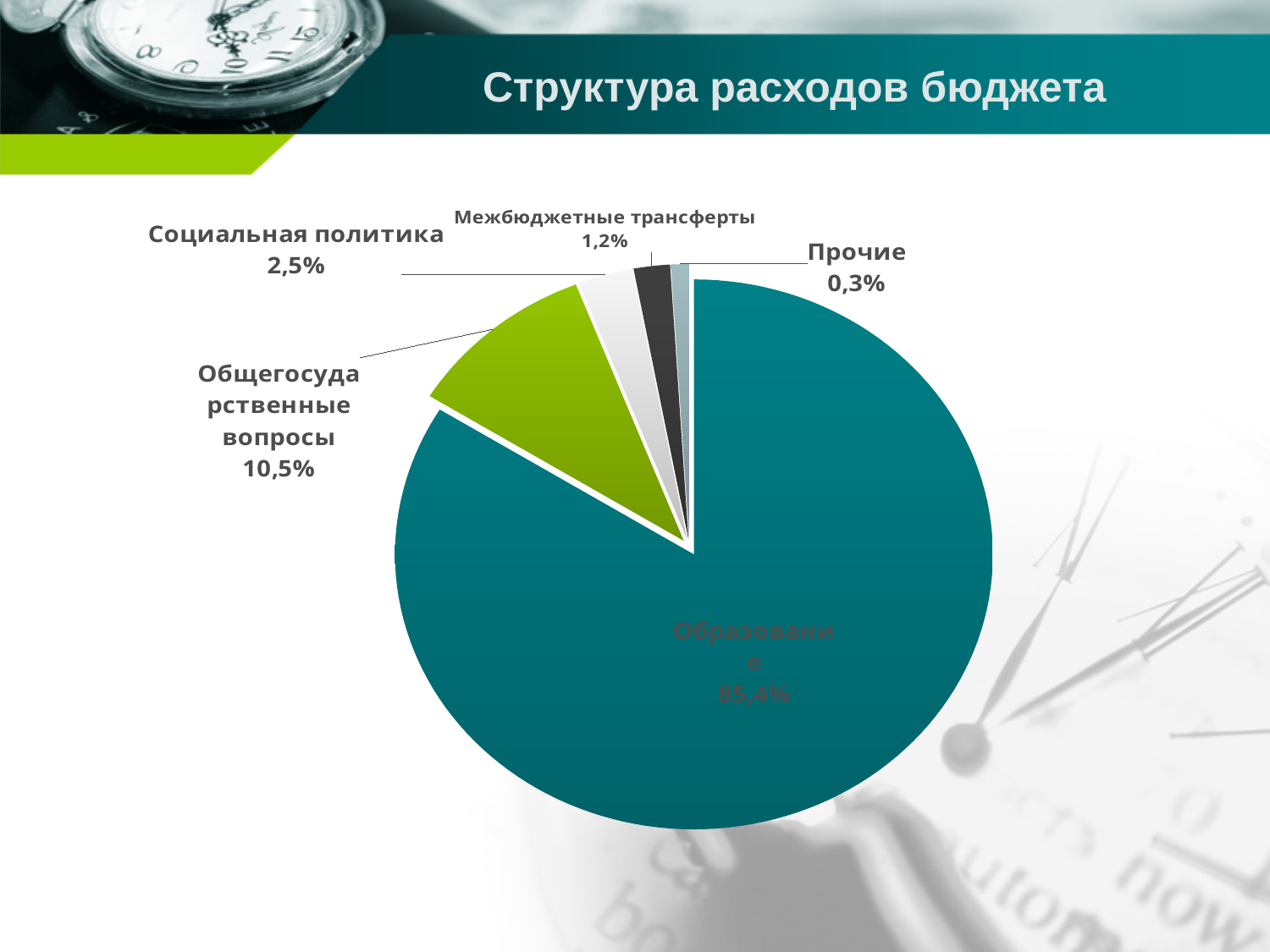
What share is labelled for Прочие? 0,3% What share of the pie does Образование account for? 85,4% Which is larger, Социальная политика or Межбюджетные трансферты? Социальная политика What is the difference in percentage points between Образование and Общегосударственные вопросы? 74,9 Which category has the smallest slice of the pie? Прочие What is the value shown for Общегосударственные вопросы? 10,5% How many slices does the pie chart have? 5 What type of chart is shown on the slide? Pie chart What is the title of the slide containing the chart? Структура расходов бюджета Which category has the largest slice of the pie? Образование What percentage is shown for Социальная политика? 2,5% What is the value for Межбюджетные трансферты? 1,2%